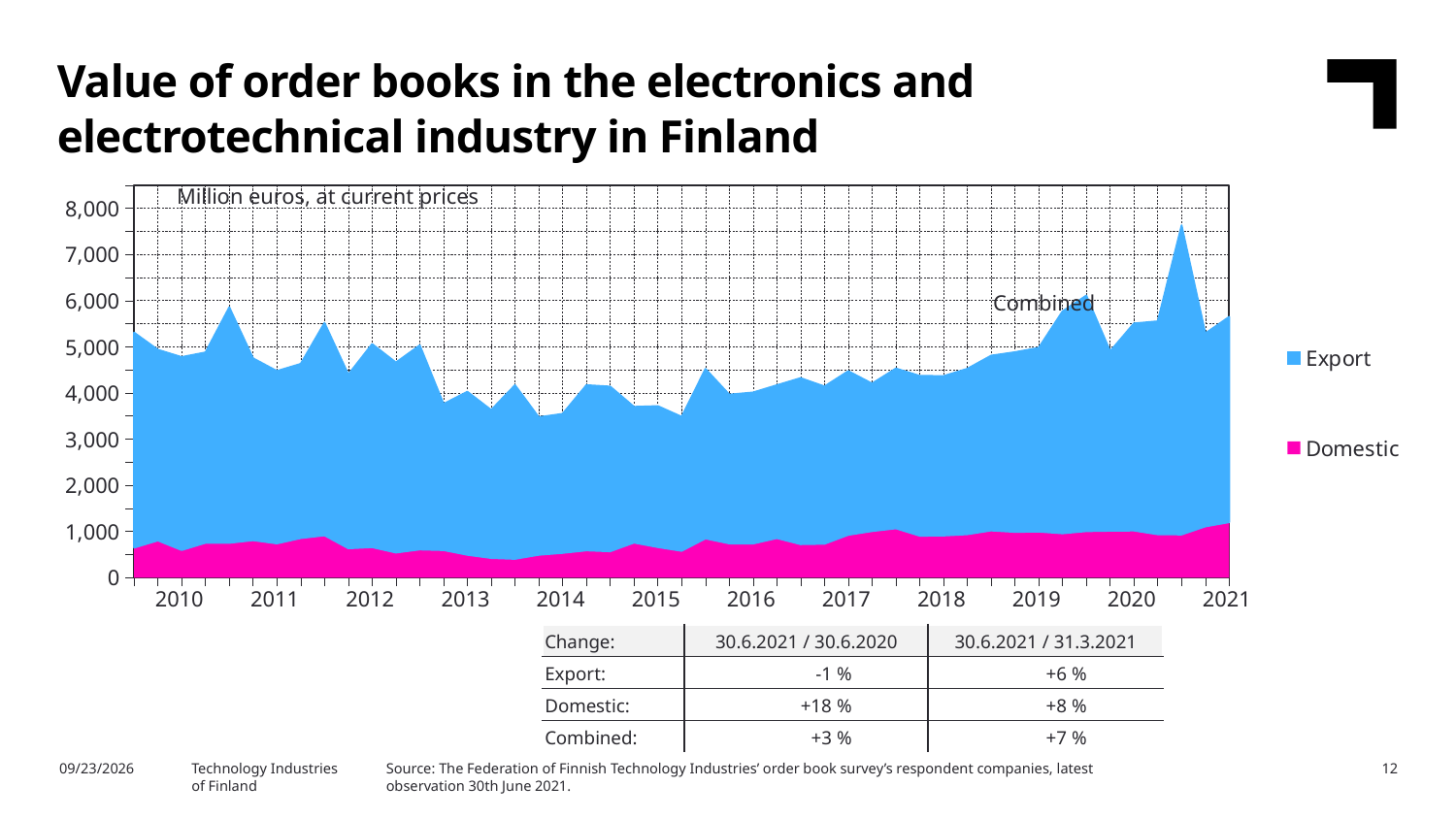
Which series has the larger values throughout the chart, Export or Domestic? Export Is the combined value in 2016 greater or less than 5,000? less According to the table below the chart, what is the Domestic change for 30.6.2021 / 30.6.2020? +18 % Is the combined value at the start of 2010 greater or less than 5,000? greater Is the Domestic value in 2014 greater or less than 1,000? less What kind of chart is shown on the slide? Stacked area chart What are the two series named in the legend? Export and Domestic How many years are labelled on the x axis? 12 How many series does the legend list? 2 In which year does the combined value reach its highest peak? 2020 What unit is stated at the top of the chart's y axis? Million euros, at current prices